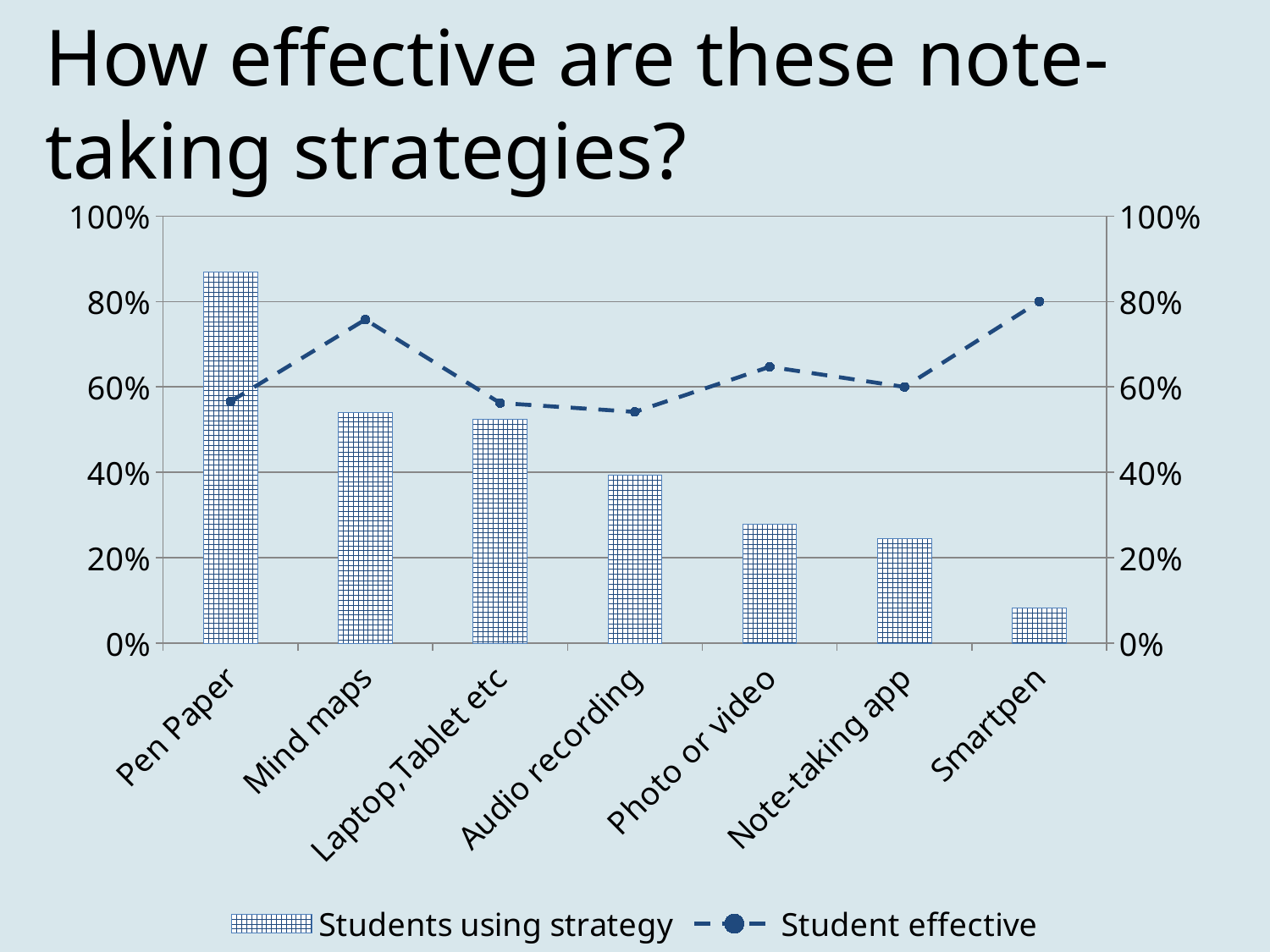
Is the Student effective value for Mind maps greater or less than 60%? greater Which strategy has the lowest bar for Students using strategy? Smartpen Which strategy has the highest bar for Students using strategy? Pen Paper Which has a larger Students using strategy value, Pen Paper or Mind maps? Pen Paper What are the two series named in the legend? Students using strategy and Student effective Is the Students using strategy value for Smartpen greater or less than 20%? less Do the Students using strategy bars rise or fall from left to right across the x axis? fall What kind of chart is shown on the slide? A combined bar and line chart Is the Students using strategy value for Pen Paper greater or less than 80%? greater How many series does the legend list? 2 How many note-taking strategies are shown on the x axis? 7